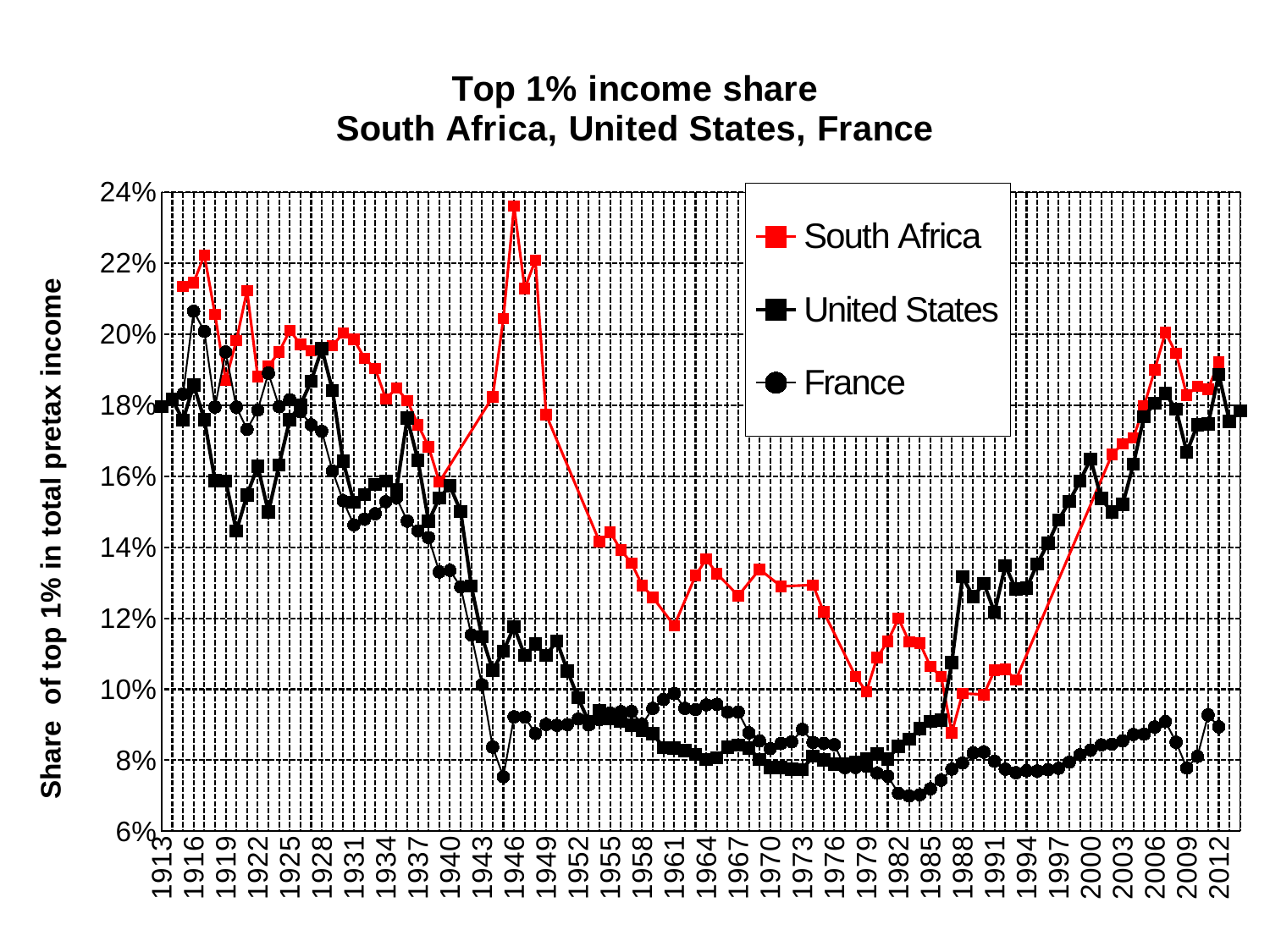
Which series is plotted with circular markers? France In 1955, which is larger: the value for South Africa or the value for the United States? South Africa Is the value for France in 1982 greater or less than 8%? less Does the value for France generally rise or fall from 1913 to 1982? fall What kind of chart is shown on the slide? line chart Which series has the lowest value in 2000? France Which series has the highest value in 1946? South Africa Is the value for France in 1916 greater or less than 20%? greater Is the value for South Africa in 1946 greater or less than 22%? greater What is the title of the chart? Top 1% income share South Africa, United States, France How many series does the legend list? 3